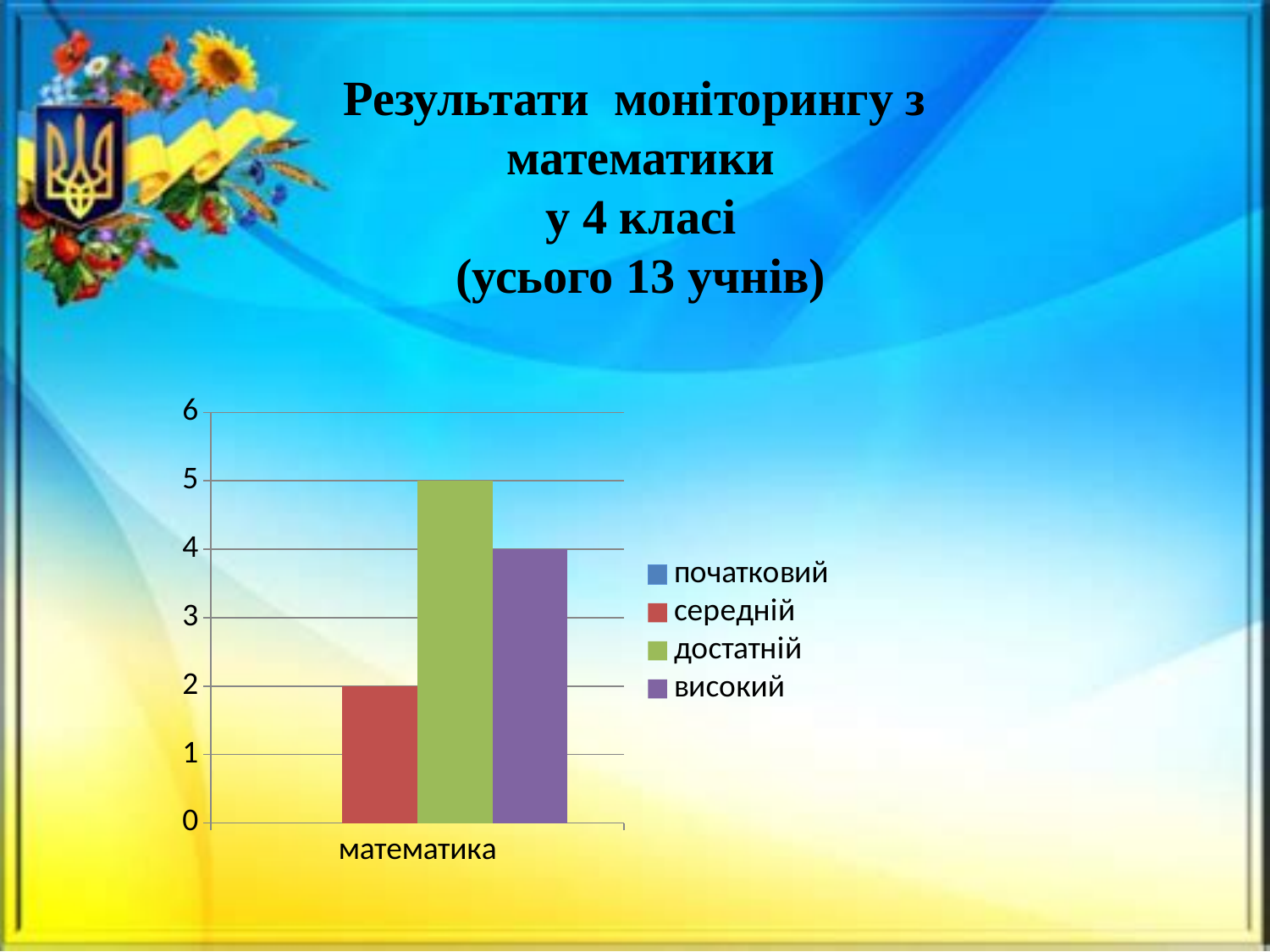
How many series does the legend list? 4 What kind of chart is shown on the slide? bar chart What is the difference between the values for "достатній" and "середній"? 3 What is the value for the series "високий"? 4 What colour is the bar for the series "достатній"? green Is the value for "високий" greater or less than 3? greater What is the category label shown on the x axis? математика What is the value for the series "достатній"? 5 Which series has the highest bar? достатній Which of the visible bars is the lowest? середній Which is larger, the value for "високий" or the value for "середній"? високий What is the value for the series "середній"? 2